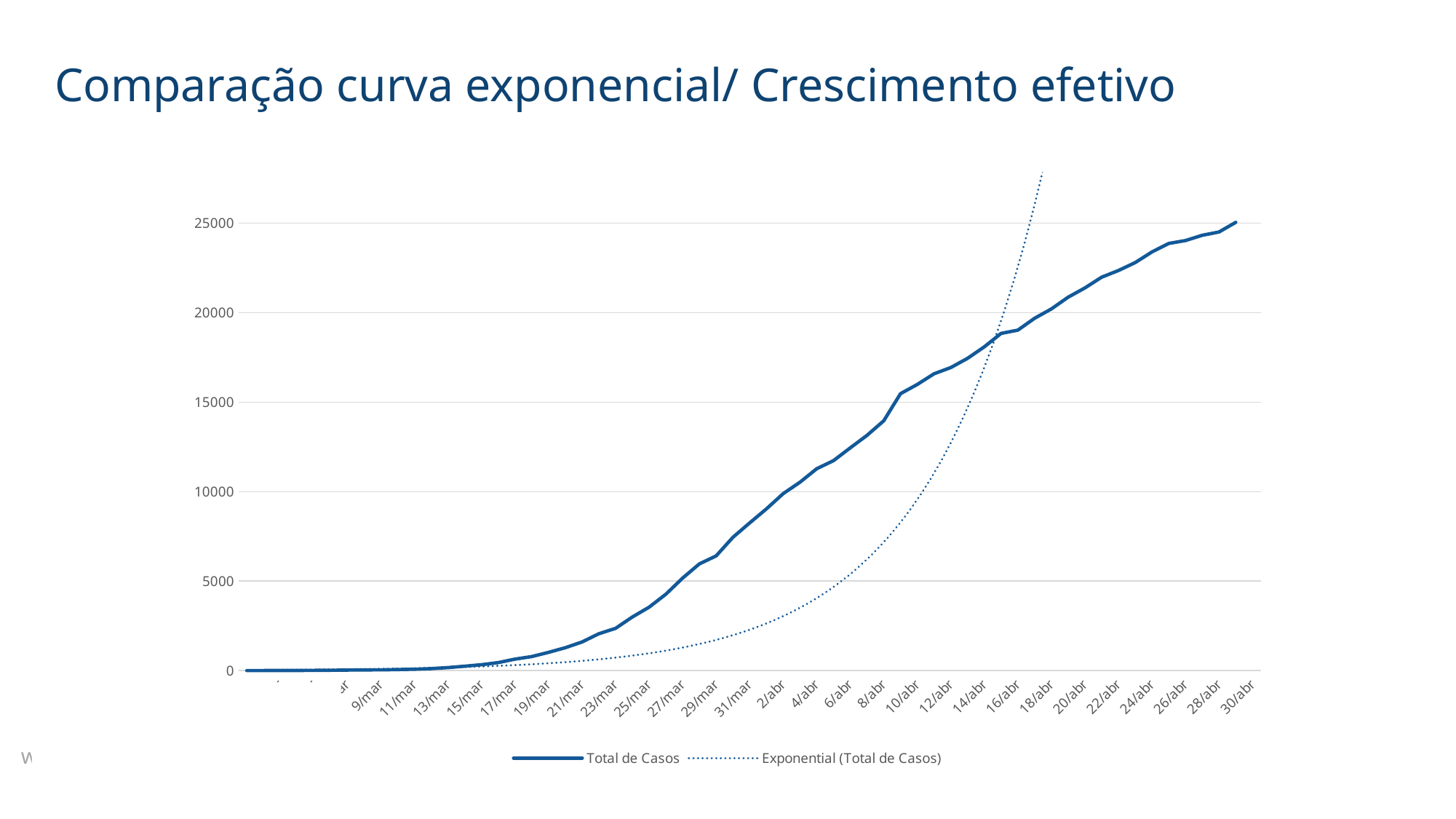
On 10/abr, which series has the higher value: Total de Casos or Exponential (Total de Casos)? Total de Casos What kind of chart is shown on the slide? line chart Does the Total de Casos line rise or fall from left to right along the x axis? rise What is the title of the chart on the slide? Comparação curva exponencial/ Crescimento efetivo Is the value of Total de Casos on 26/abr greater or less than 25000? less Is the value of Total de Casos on 16/abr greater or less than 20000? less Is the value of Total de Casos on 30/abr greater or less than 20000? greater How many series does the legend list? 2 Which series is drawn with a dotted line? Exponential (Total de Casos) On 18/abr, which series has the higher value: Total de Casos or Exponential (Total de Casos)? Exponential (Total de Casos)